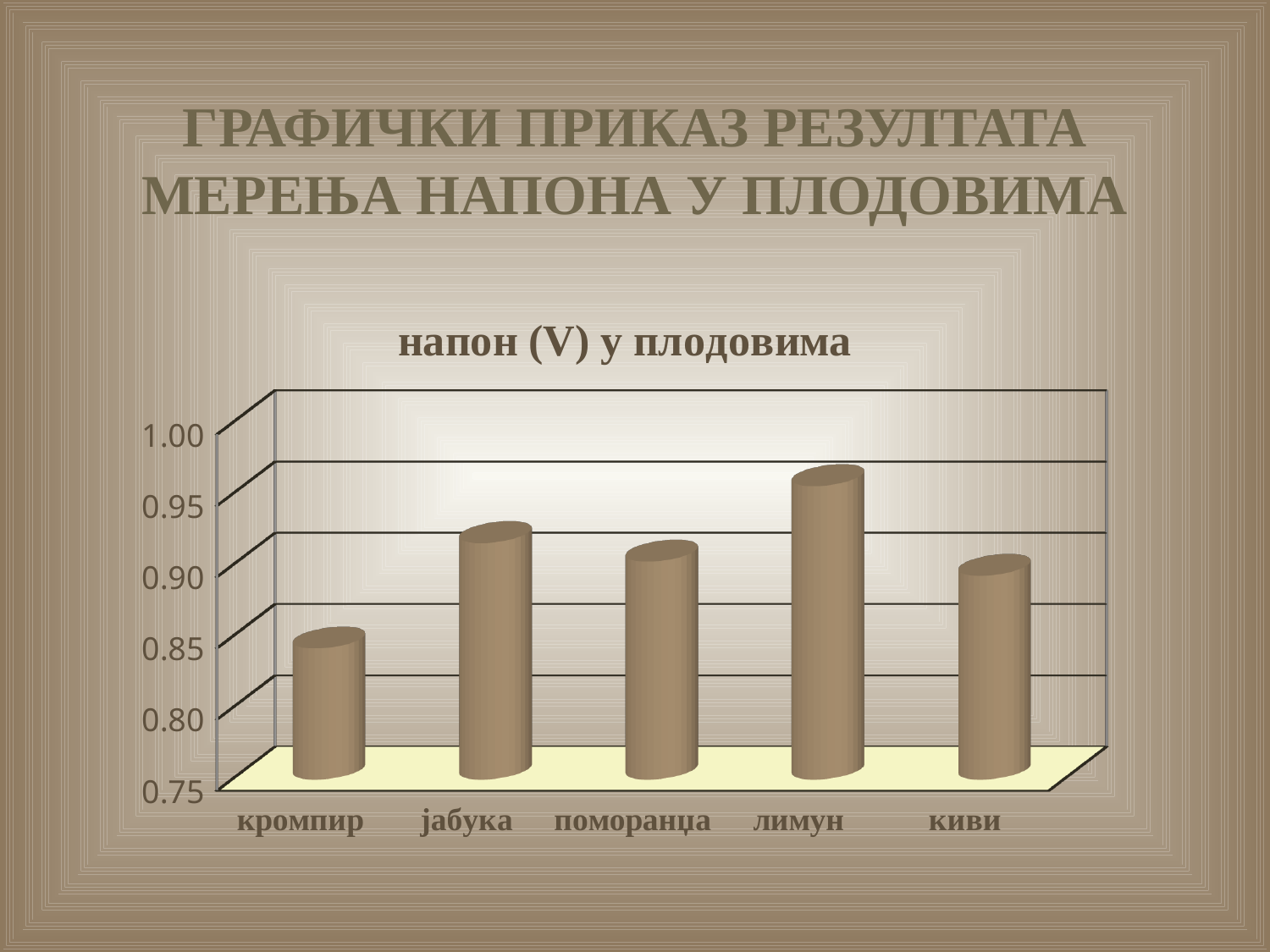
Which has a larger value, лимун or киви? лимун Which has a larger value, јабука or кромпир? јабука Is the value for лимун greater or less than 0.90? greater Which has a larger value, лимун or кромпир? лимун How many categories are plotted in the chart? 5 What kind of chart is shown on the slide? bar chart Which category has the lowest value? кромпир Is the value for кромпир greater or less than 0.90? less Is the value for поморанџа greater or less than 0.85? greater Which category has the highest value? лимун What is the title of the chart? напон (V) у плодовима